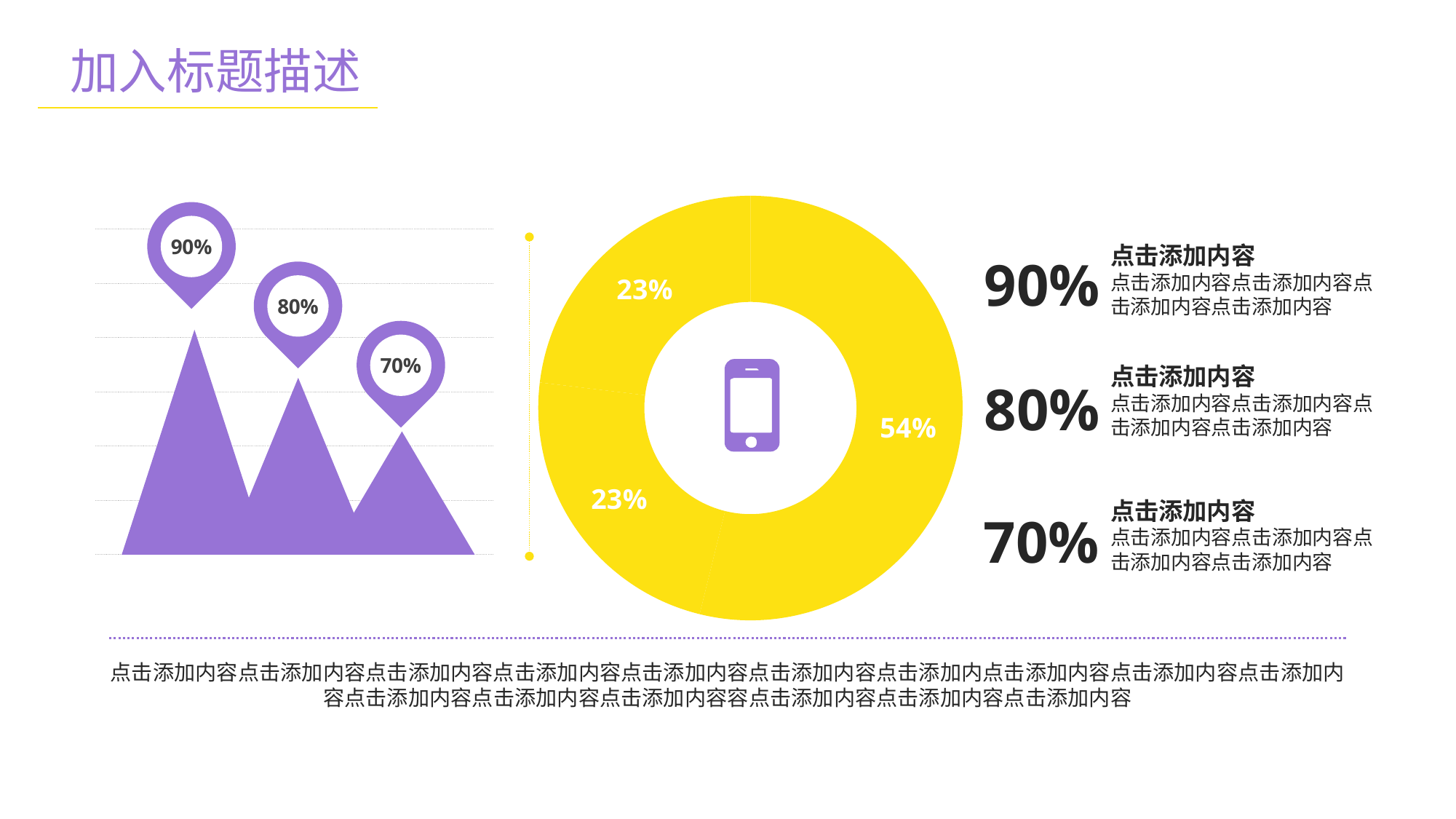
On the left chart, which peak has the highest value? The leftmost peak (90%) On the left chart, what value is shown for the rightmost peak? 70% On the right chart, what is the difference between the largest slice and one of the 23% slices? 31% On the left chart, how many peaks (data points) are shown? 3 On the left chart, do the values rise or fall from left to right? Fall On the right chart, how many slices does the doughnut have? 3 On the left chart, which peak has the lowest value? The rightmost peak (70%) On the left chart, what is the difference between the leftmost peak and the rightmost peak? 20% What kind of chart is shown on the right side of the slide? Doughnut (pie) chart On the left chart, what value is shown for the middle peak? 80% On the right chart, what is the value of the largest slice? 54% On the left chart, what value is shown for the leftmost peak? 90%